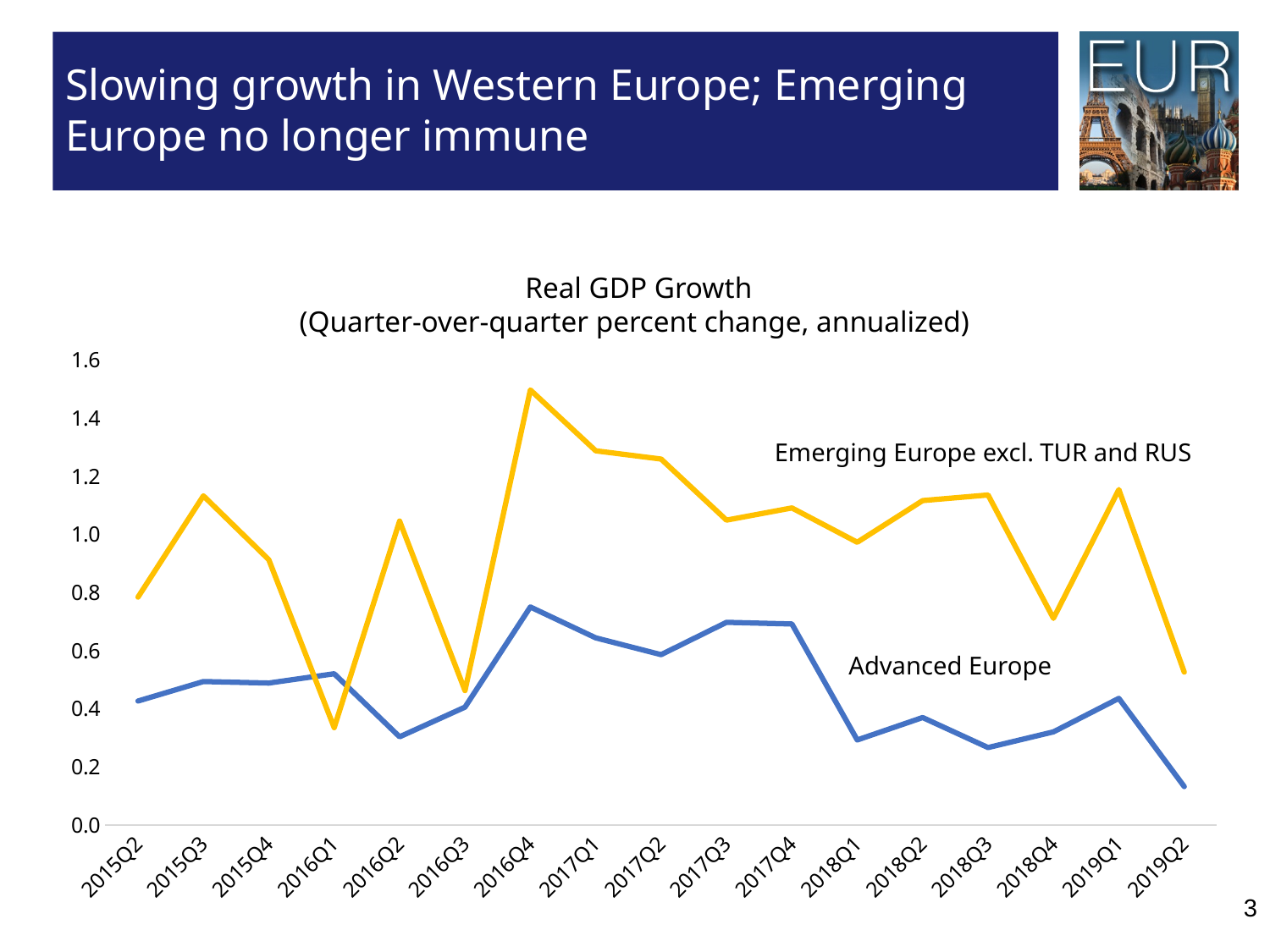
In which quarter does the Emerging Europe excl. TUR and RUS line reach its lowest value? 2016Q1 How many series are plotted in the Real GDP Growth chart? 2 What kind of chart is shown on the slide? Line chart How many quarters are shown on the x axis of the chart? 17 Is the value for Advanced Europe in 2019Q2 greater or less than 0.2? less In which quarter does the Emerging Europe excl. TUR and RUS line reach its highest value? 2016Q4 Is the value for Emerging Europe excl. TUR and RUS in 2016Q4 greater or less than 1.4? greater Which series has the higher value in 2017Q1, Emerging Europe excl. TUR and RUS or Advanced Europe? Emerging Europe excl. TUR and RUS In which quarter does the Advanced Europe line reach its highest value? 2016Q4 Does the Advanced Europe line rise or fall from 2019Q1 to 2019Q2? Fall What is the title of the chart? Real GDP Growth (Quarter-over-quarter percent change, annualized) In which quarter does the Advanced Europe line reach its lowest value? 2019Q2